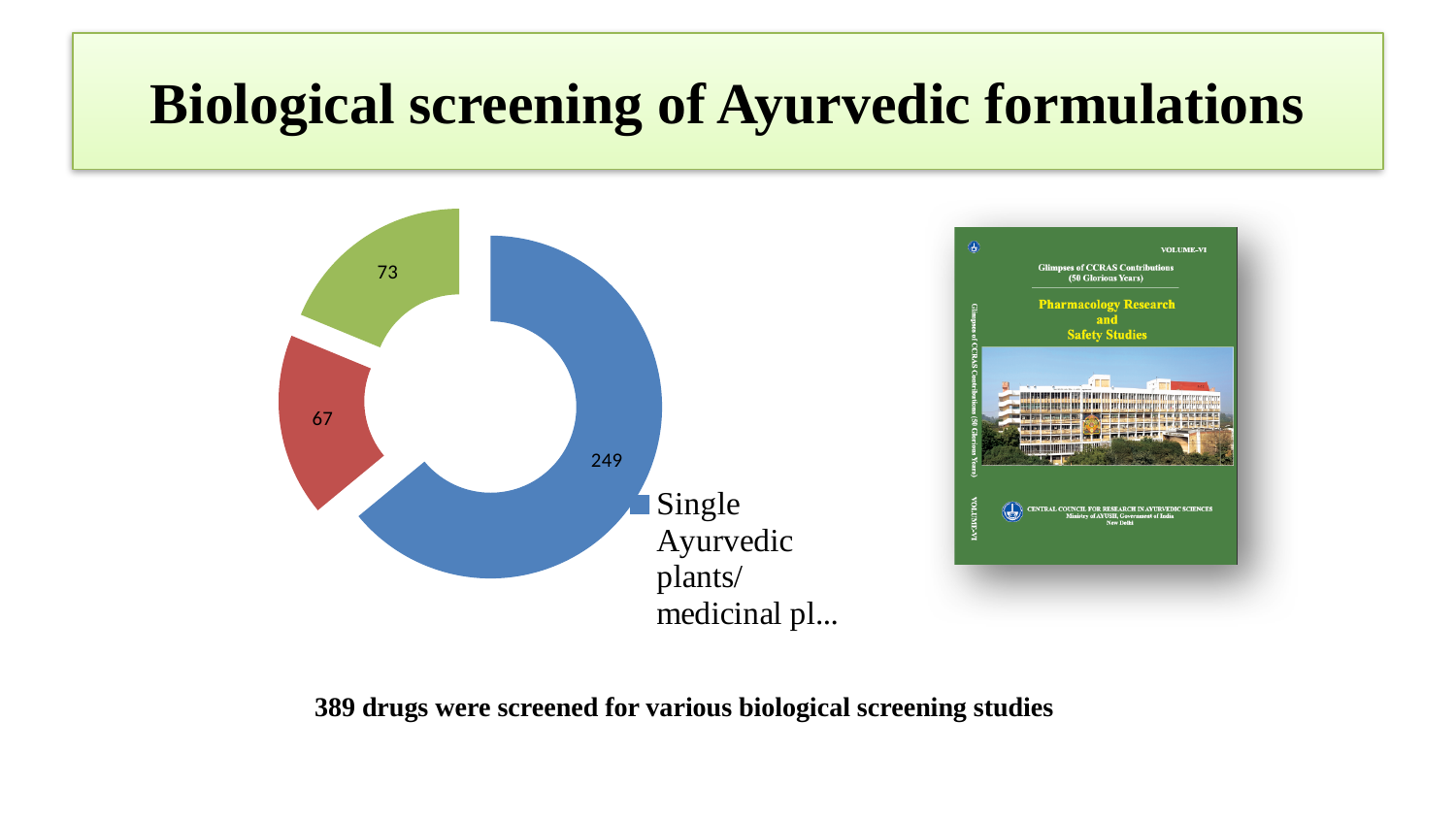
What share of the total does the blue slice (249) represent? 64% What is the value of the green slice in the doughnut chart? 73 What is the value of the red slice in the doughnut chart? 67 What is the difference between the blue slice value and the green slice value? 176 Which is larger, the green slice value or the red slice value? The green slice (73) What is the difference between the green slice value and the red slice value? 6 What is the value of the blue slice in the doughnut chart? 249 How many slices does the doughnut chart have? 3 What kind of chart is shown on the slide? Doughnut chart Which slice of the doughnut chart has the smallest value? The red slice (67) What is the total of all three slice values in the doughnut chart? 389 Which slice of the doughnut chart has the largest value? The blue slice (249)